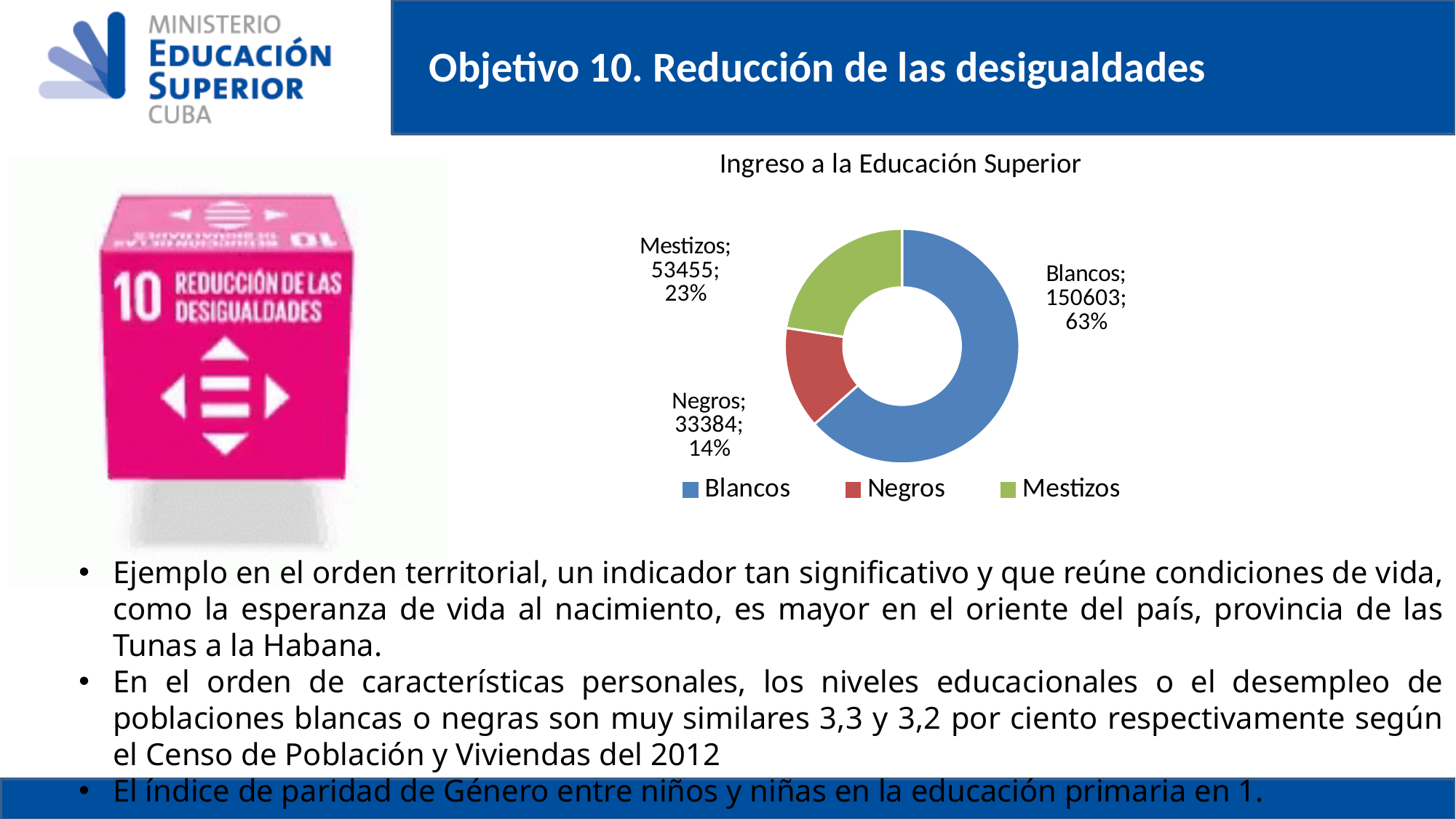
Which is larger, the value for Mestizos or the value for Negros? Mestizos What kind of chart is shown on the slide? Doughnut (pie) chart What is the value for Negros? 33384 Which category has the smallest share of the chart? Negros What is the title of the chart? Ingreso a la Educación Superior How many categories does the chart show? 3 Which category has the largest share of the chart? Blancos What is the value for Blancos? 150603 What percentage share does Negros have? 14% What is the difference between the values for Blancos and Mestizos? 97148 What is the value for Mestizos? 53455 What percentage share does Mestizos have? 23%